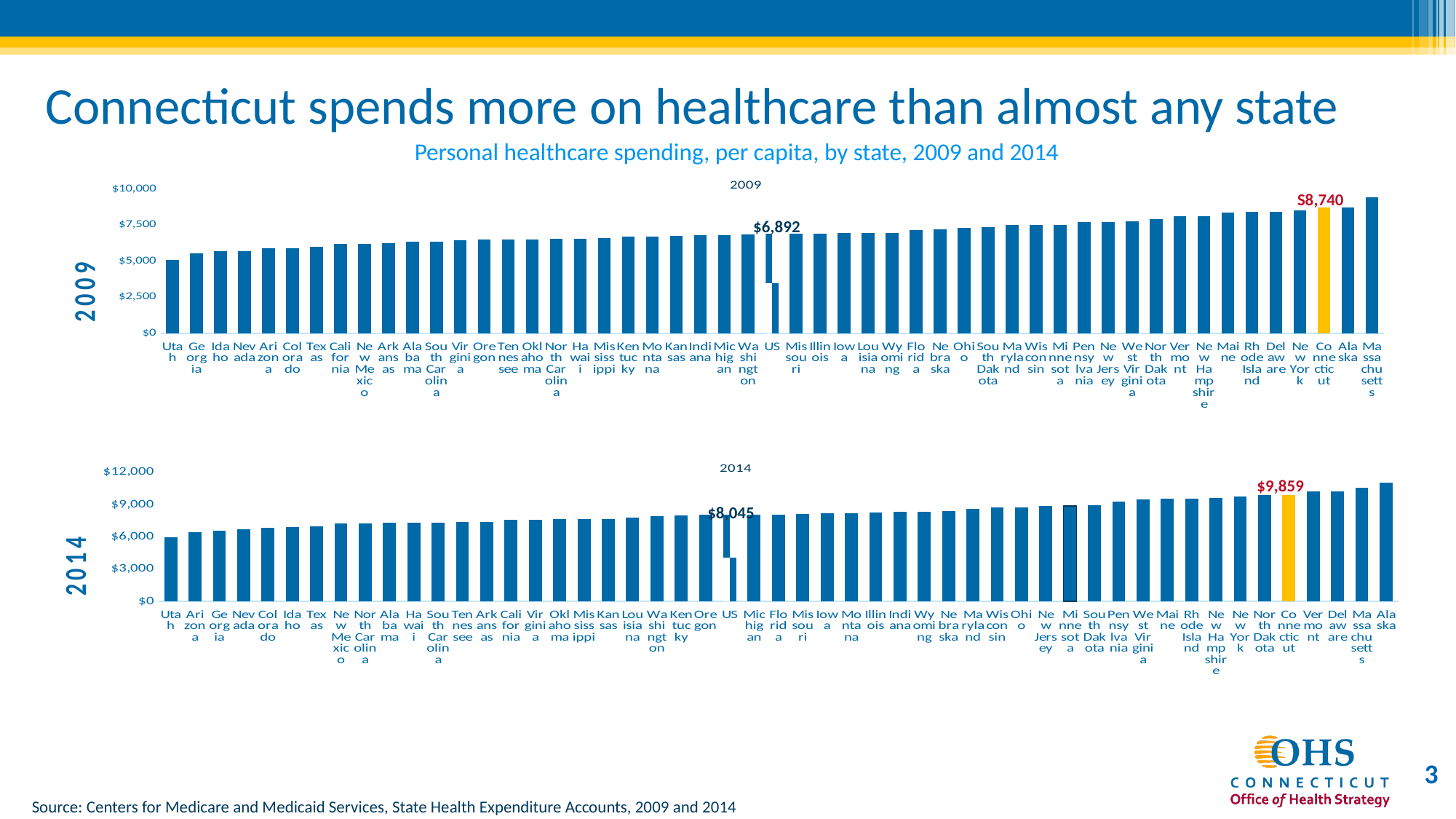
In the 2014 chart, what is the value labeled for Connecticut? $9,859 In the 2009 chart, what is the per capita healthcare spending value labeled for Connecticut? $8,740 In the 2014 chart, what is the value labeled for the US? $8,045 In the 2009 chart, how much higher is Connecticut's labeled value than the US value? $1,848 What kind of chart is used for the 2014 data? Bar chart In the 2014 chart, which state has the highest per capita spending? Alaska In the 2009 chart, is the value for Georgia greater or less than $7,500? less In the 2009 chart, which state has the highest per capita spending? Massachusetts In the 2014 chart, is the value for Alaska greater or less than $9,000? greater In the 2014 chart, how much higher is Connecticut's labeled value than the US value? $1,814 In the 2009 chart, what is the value labeled for the US? $6,892 In the 2009 chart, which state has the lowest per capita spending? Utah